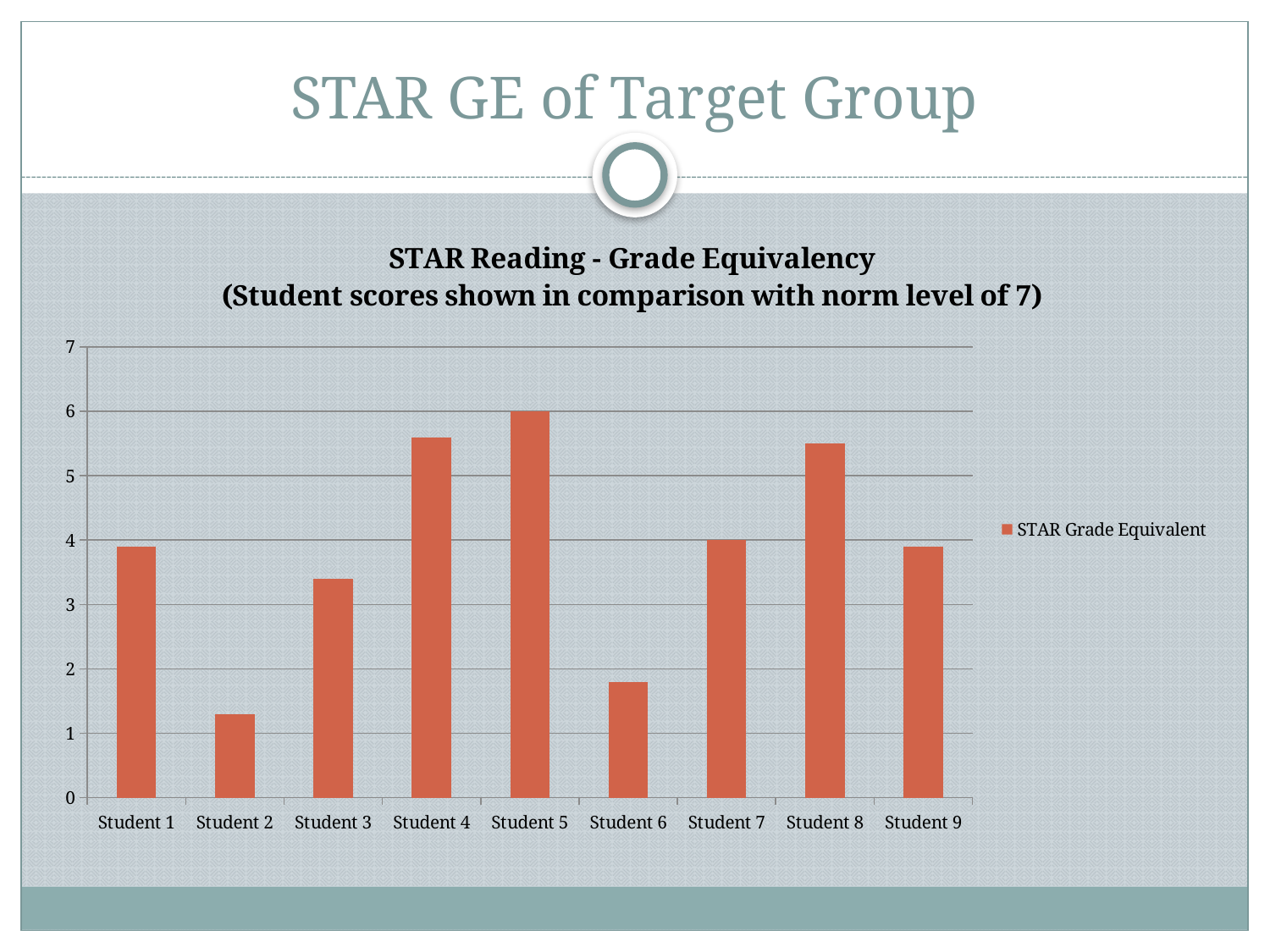
Is the value for Student 6 greater or less than 2? less Which has a larger STAR Grade Equivalent, Student 4 or Student 6? Student 4 What is the STAR Grade Equivalent for Student 5? 6 What is the STAR Grade Equivalent for Student 7? 4 What is the name of the series listed in the chart's legend? STAR Grade Equivalent What type of chart is shown on the slide? Bar chart Which student has the lowest STAR Grade Equivalent? Student 2 How many students are shown on the x axis of the chart? 9 Is the value for Student 4 greater or less than 5? greater How many series does the chart's legend list? 1 Which student has the highest STAR Grade Equivalent? Student 5 Is the value for Student 2 greater or less than 2? less